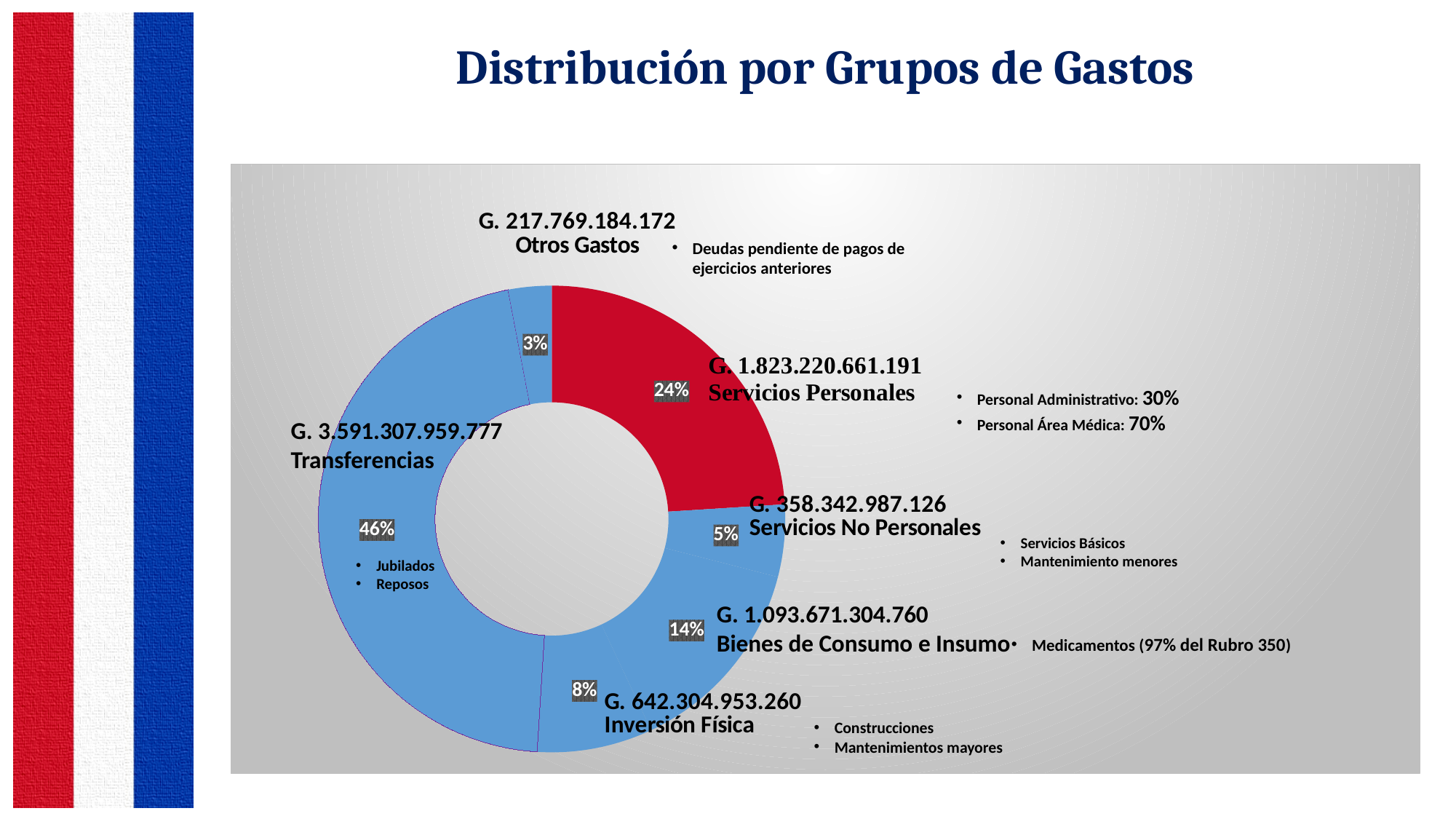
What is the amount shown for Inversión Física? G. 642.304.953.260 What percentage share does Transferencias have in the chart? 46% Which expense group has the smallest share of the chart? Otros Gastos What percentage share does Bienes de Consumo e Insumo have in the chart? 14% What kind of chart is shown on the slide? Doughnut chart What percentage share does Otros Gastos have in the chart? 3% Which has a larger share, Servicios Personales or Bienes de Consumo e Insumo? Servicios Personales What is the difference in percentage points between the shares of Transferencias and Servicios Personales? 22 percentage points Which expense group has the largest share of the chart? Transferencias How many expense groups are shown in the chart? 6 What is the amount shown for Servicios No Personales? G. 358.342.987.126